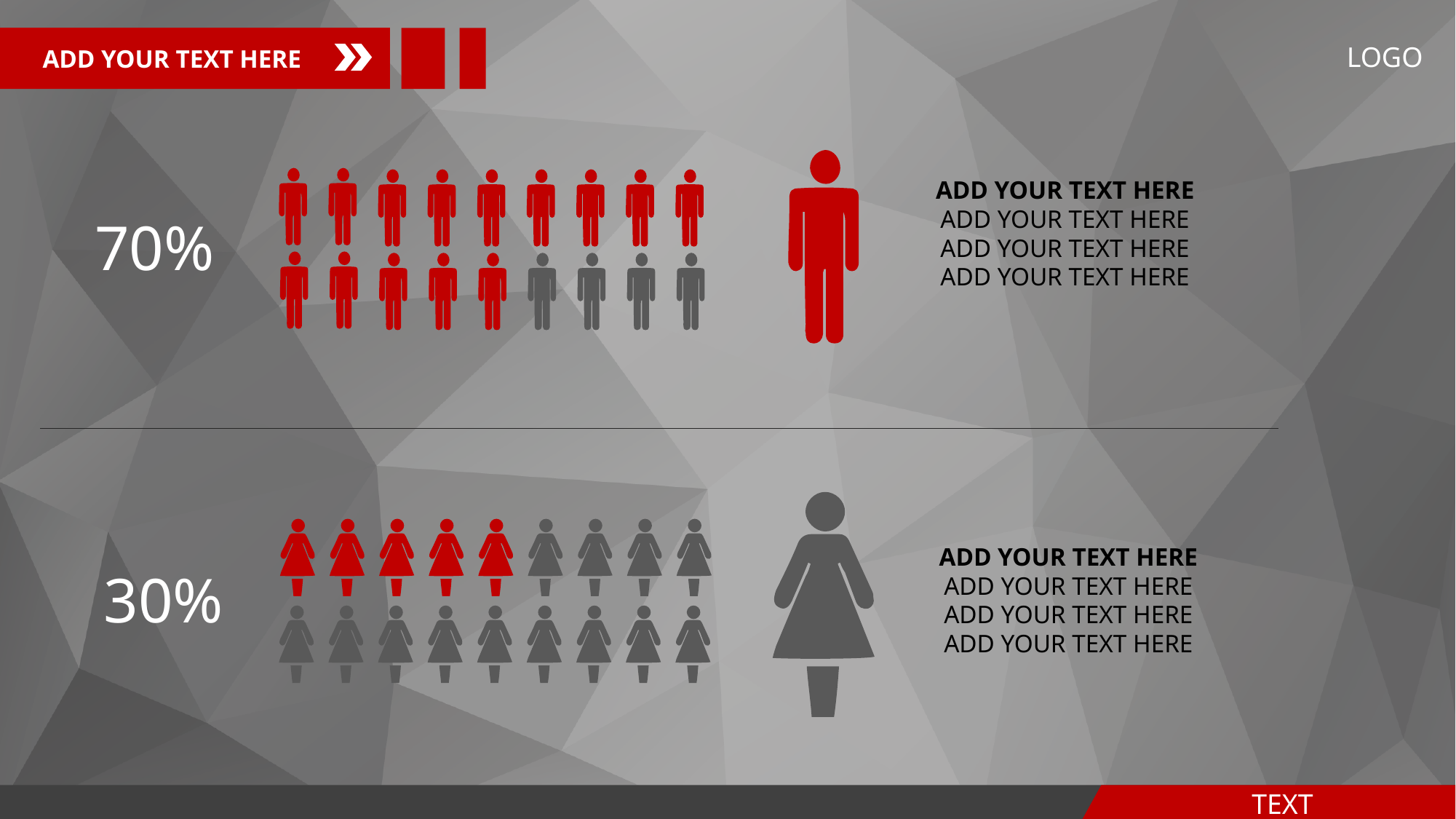
What percentage is shown next to the bottom chart with the female figure icons? 30% What percentage is shown next to the top chart with the male figure icons? 70% How many pictograph charts are on the slide? 2 What colour are the highlighted (filled) icons in both charts? Red How many rows of small icons does the top chart have? 2 Is the percentage on the top chart greater or less than 50%? greater Which chart shows the larger percentage, the top (male icons) chart or the bottom (female icons) chart? The top (male icons) chart, 70% What kind of chart is used on this slide to show the percentages? Pictograph (icon array) What do the two percentages on the slide add up to? 100% What is the difference between the percentage on the top chart and the percentage on the bottom chart? 40 percentage points Is the percentage on the bottom chart greater or less than 50%? less Which chart, top or bottom, uses female figure icons? The bottom chart (30%)